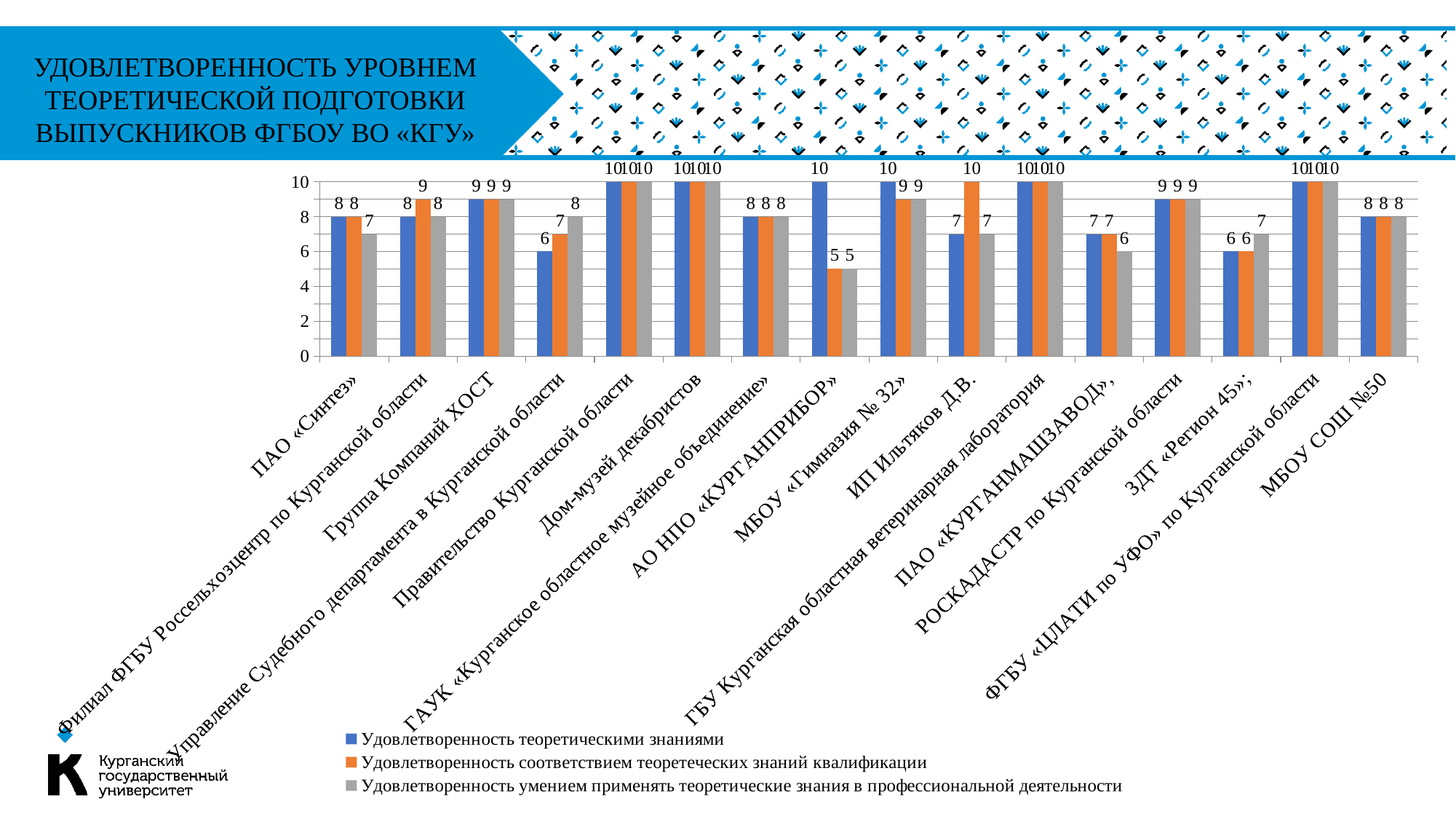
Which is larger for Управление Судебного департамента в Курганской области: «Удовлетворенность теоретическими знаниями» or «Удовлетворенность умением применять теоретические знания в профессиональной деятельности»? Удовлетворенность умением применять теоретические знания в профессиональной деятельности What colour are the bars for «Удовлетворенность соответствием теоретеческих знаний квалификации»? Orange What is the value of «Удовлетворенность теоретическими знаниями» for АО НПО «КУРГАНПРИБОР»? 10 How many organisations (categories) are shown on the x axis? 16 What is the value of «Удовлетворенность умением применять теоретические знания в профессиональной деятельности» for ПАО «Синтез»? 7 What is the value of «Удовлетворенность соответствием теоретеческих знаний квалификации» for ИП Ильтяков Д.В.? 10 What is the difference between the «Удовлетворенность теоретическими знаниями» value and the «Удовлетворенность соответствием теоретеческих знаний квалификации» value for АО НПО «КУРГАНПРИБОР»? 5 What is the value of «Удовлетворенность соответствием теоретеческих знаний квалификации» for АО НПО «КУРГАНПРИБОР»? 5 Which organisation has the lowest value for «Удовлетворенность соответствием теоретеческих знаний квалификации»? АО НПО «КУРГАНПРИБОР» Is the value of «Удовлетворенность теоретическими знаниями» for ЗДТ «Регион 45» greater or less than 8? less What kind of chart is shown on the slide? Bar chart How many series does the legend list? 3